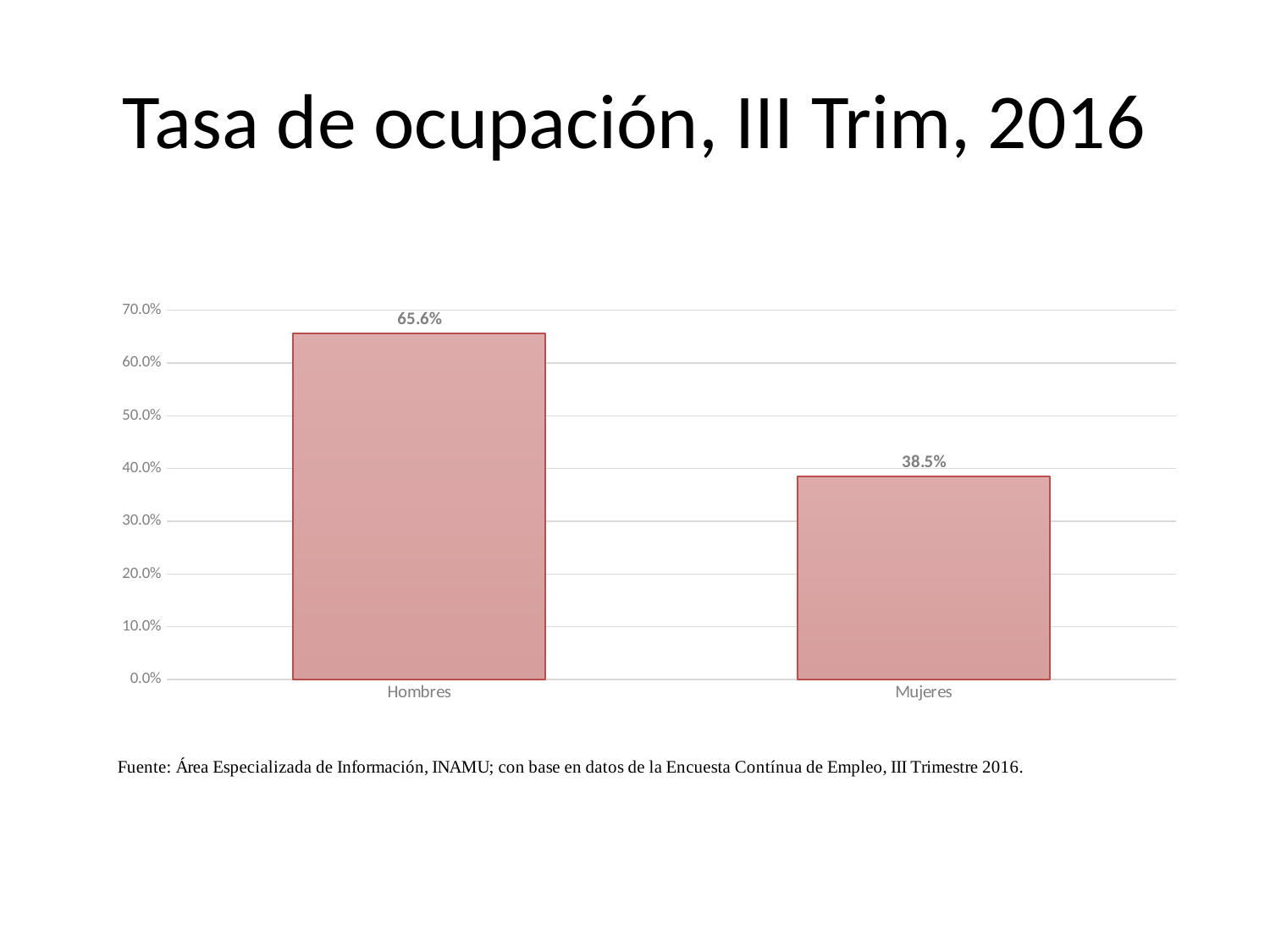
Which category has the lowest value? Mujeres Is the value for Mujeres greater or less than 40.0%? less What is the value for Hombres? 65.6% What is the difference between the values for Hombres and Mujeres? 27.1% How many categories are shown on the x axis? 2 Which category has the highest value? Hombres What is the value for Mujeres? 38.5% What is the highest value shown on the y axis? 70.0% What is the title of the slide? Tasa de ocupación, III Trim, 2016 Which is larger, the value for Hombres or the value for Mujeres? Hombres Is the value for Hombres greater or less than 60.0%? greater What kind of chart is shown on the slide? bar chart